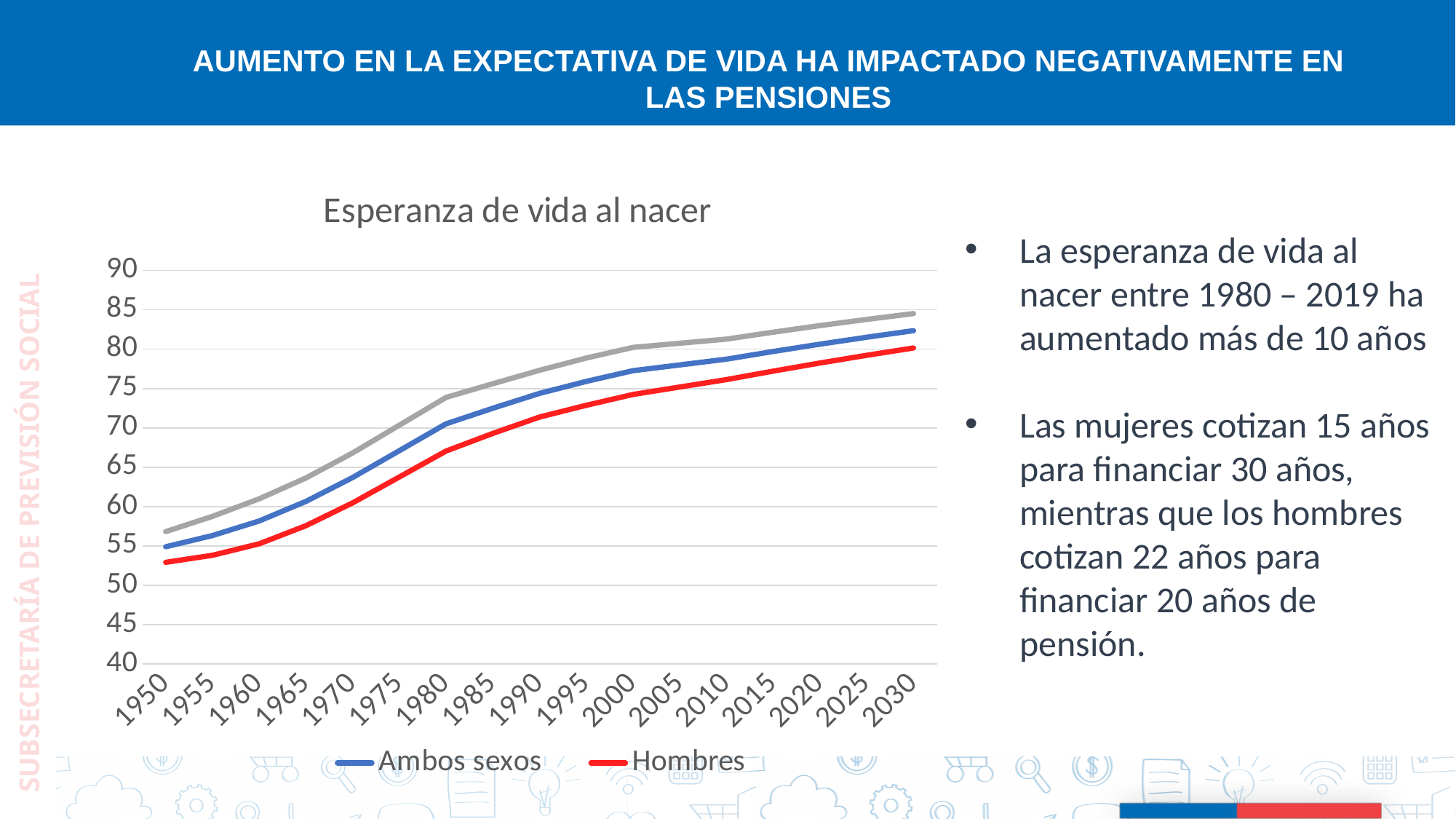
Is the value for Hombres in 1980 greater or less than 70? less Is the value for Ambos sexos in 1960 greater or less than 60? less Is the value for Hombres in 1950 greater or less than 55? less What is the title of the chart? Esperanza de vida al nacer How many series does the chart legend list? 2 Do the values for Hombres rise or fall along the x axis? rise What kind of chart is shown on the slide? line chart In 1980, which series has the larger value, Ambos sexos or Hombres? Ambos sexos Do the values for Ambos sexos rise or fall from 1950 to 2030? rise How many years are labelled along the x axis of the chart? 17